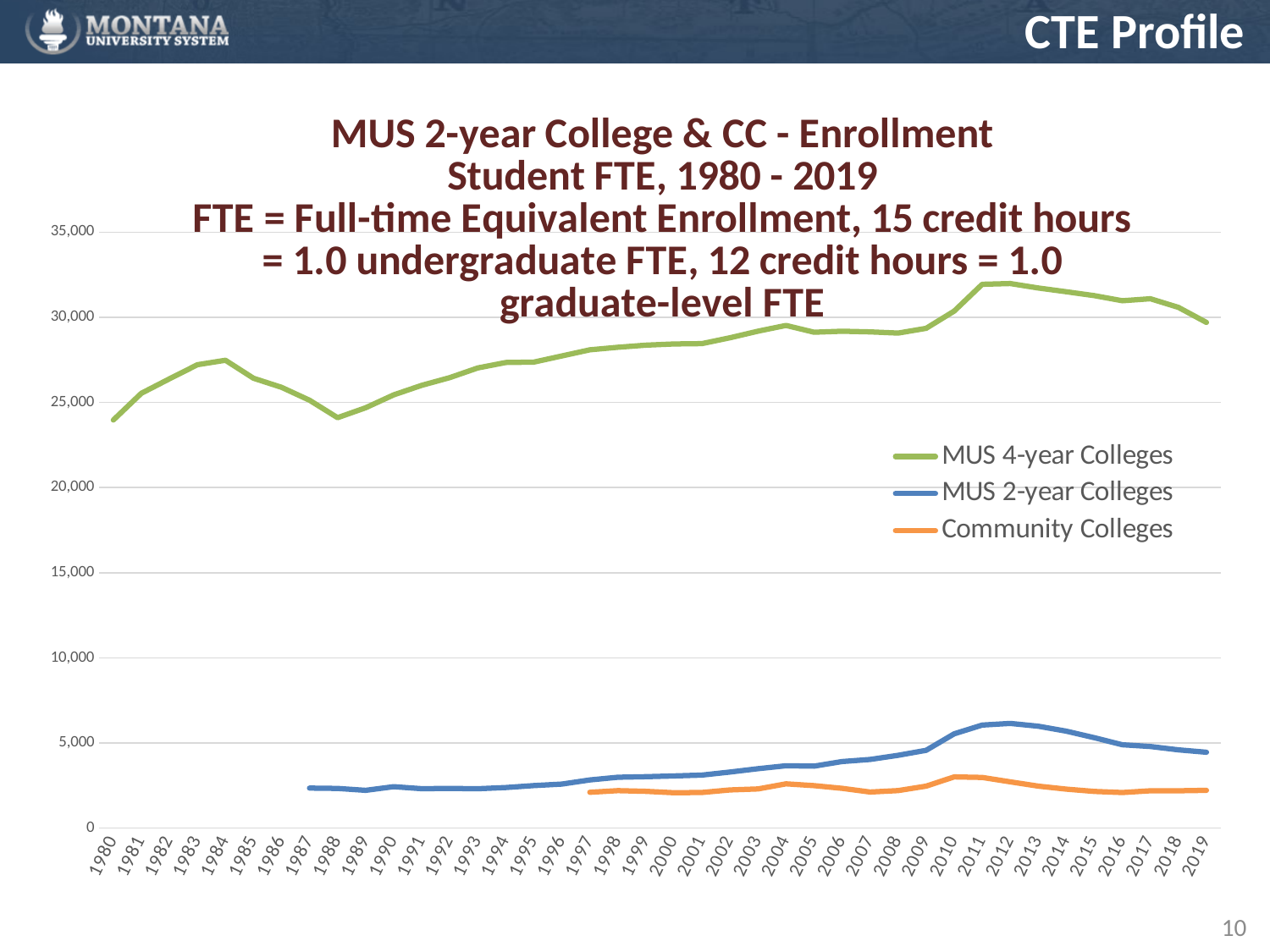
Which series has the highest values across the chart? MUS 4-year Colleges How many series does the legend list? 3 What kind of chart is shown on the slide? line chart Do the values for MUS 2-year Colleges rise or fall from 2012 to 2019? fall Is the value for MUS 4-year Colleges in 2011 greater or less than 30,000? greater Which colour is used for the Community Colleges line? orange In 2019, which is larger: MUS 4-year Colleges or MUS 2-year Colleges? MUS 4-year Colleges Is the value for MUS 2-year Colleges in 2012 greater or less than 5,000? greater Which series has the lowest values across the chart? Community Colleges Is the value for MUS 4-year Colleges in 1980 greater or less than 25,000? less How many years are shown along the x axis? 40